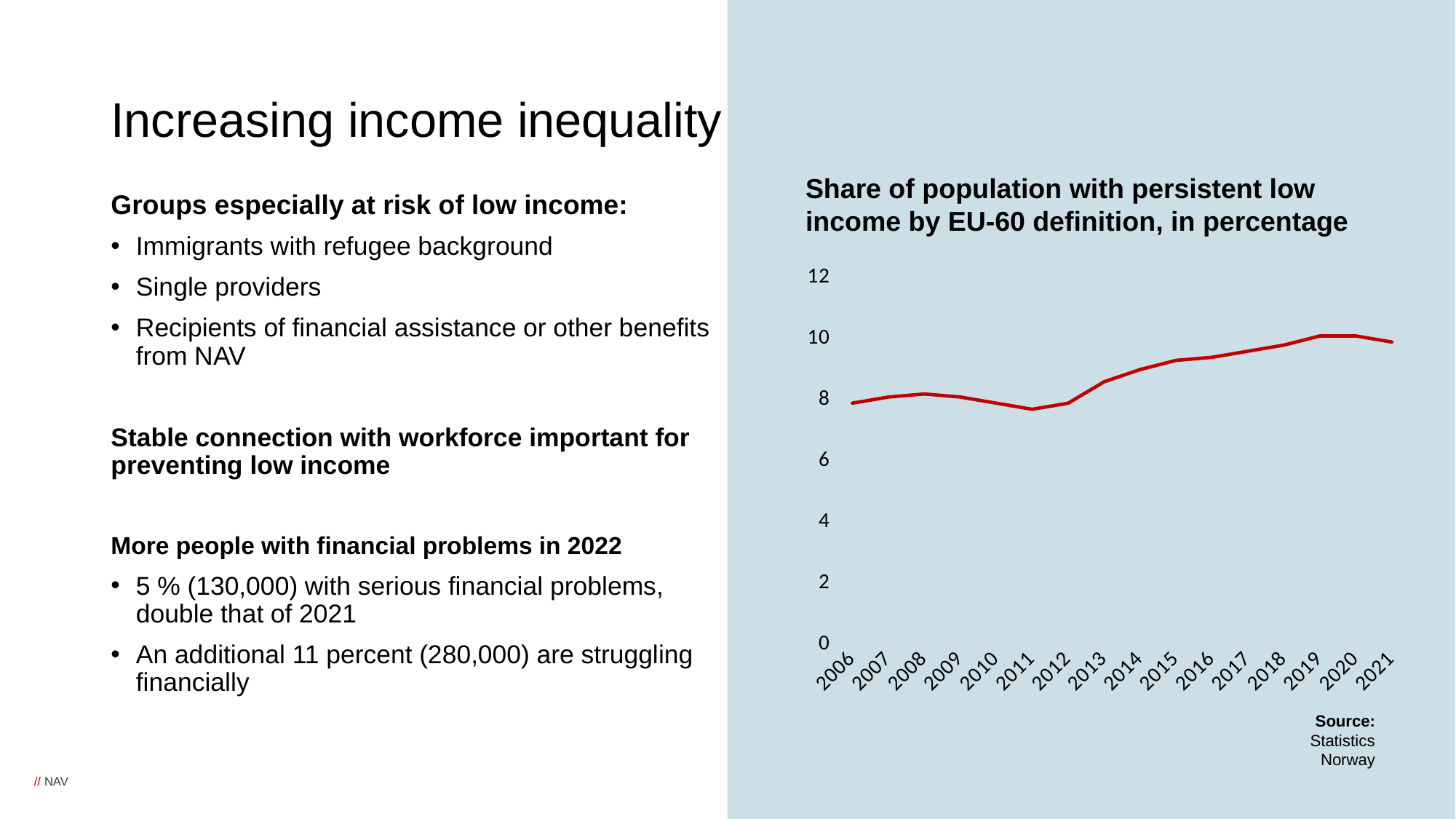
What kind of chart is shown on the slide? line chart Which year has the lowest share of population with persistent low income? 2011 What is the title of the chart? Share of population with persistent low income by EU-60 definition, in percentage Which year has the larger value, 2006 or 2018? 2018 Is the value for 2019 greater or less than 8? greater Which year has the larger value, 2011 or 2019? 2019 Is the value for 2011 greater or less than 8? less What is the source given for the chart? Statistics Norway Is the value for 2006 greater or less than 10? less How many years are plotted on the x axis of the chart? 16 Does the share of population with persistent low income generally rise or fall from 2011 to 2019? rise